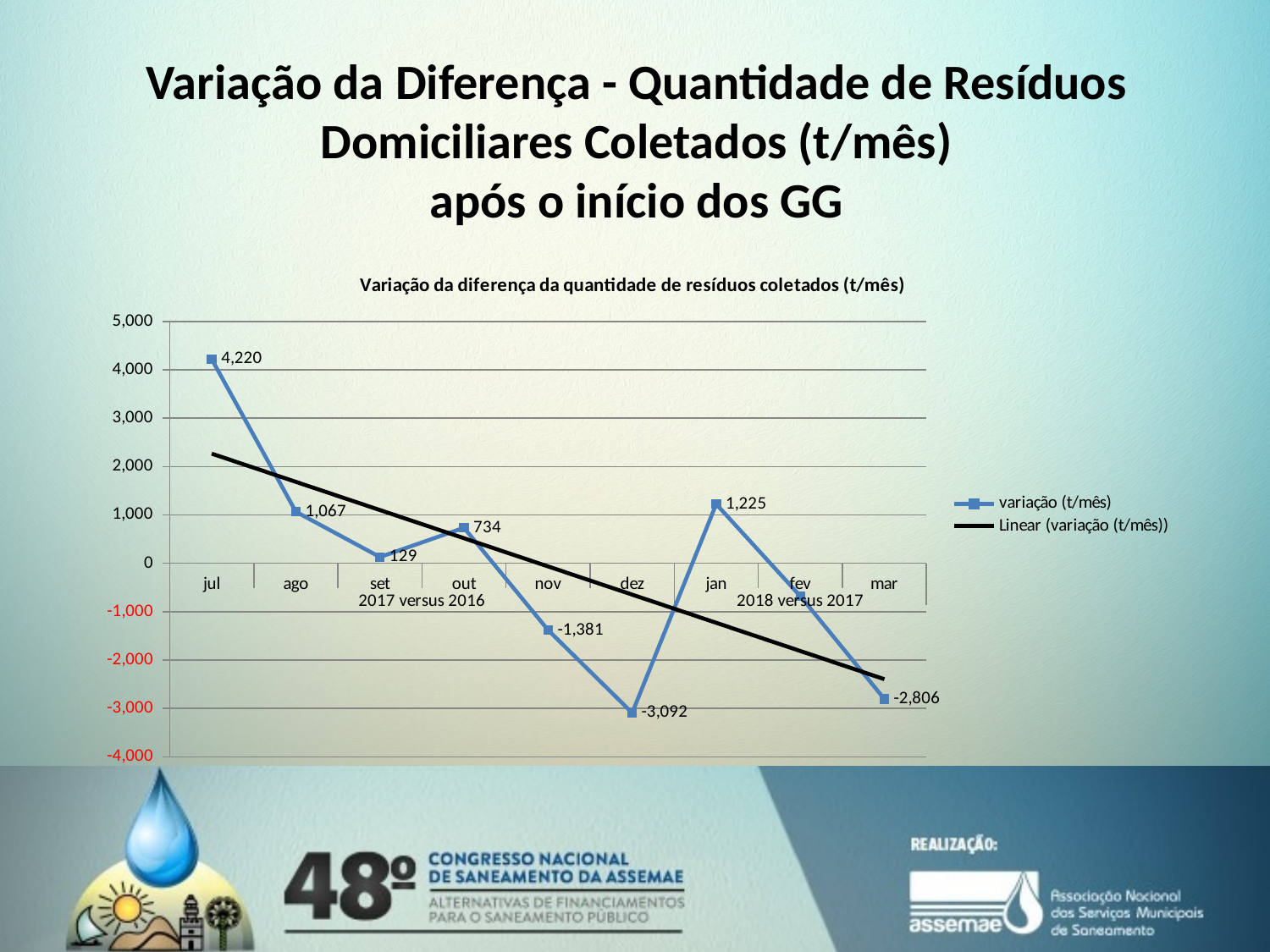
Which is larger, the value for out or the value for set? out What is the difference between the values for jul and ago? 3,153 How many series does the chart legend list? 2 How many months are plotted on the x axis of the chart? 9 What kind of chart is shown on the slide? line chart What is the value for jul in the chart? 4,220 Which month has the lowest value in the chart? dez Which month has the highest value in the chart? jul What is the value for dez in the chart? -3,092 What is the value for jan in the chart? 1,225 Is the value for fev greater or less than 0? less What is the value for mar in the chart? -2,806